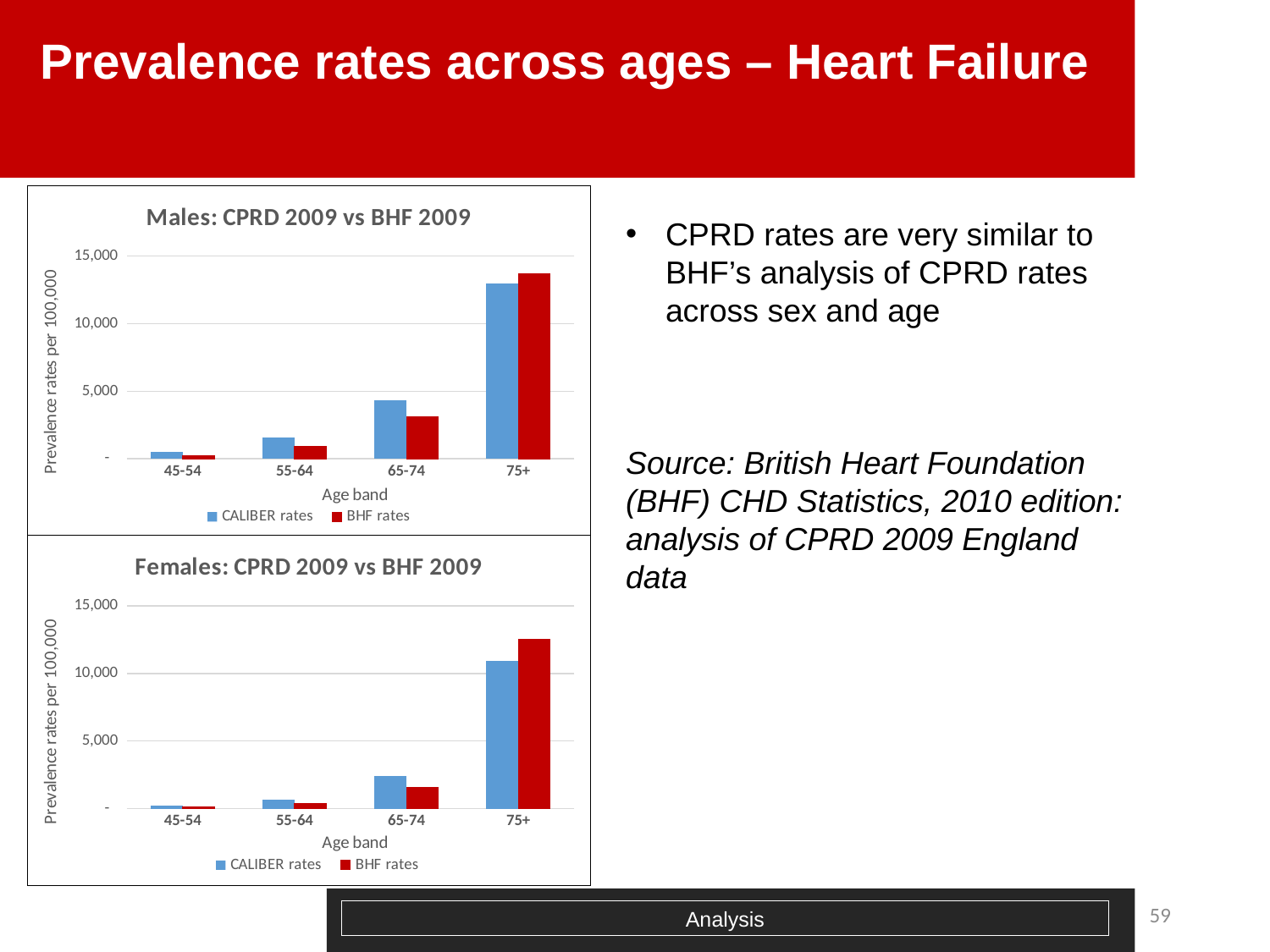
In the 'Females: CPRD 2009 vs BHF 2009' chart, do the CALIBER rates rise or fall as the age band increases? Rise In the 'Females: CPRD 2009 vs BHF 2009' chart, is the BHF rate for the 65-74 age band greater or less than 5,000? less In the 'Females: CPRD 2009 vs BHF 2009' chart, for the 75+ age band, which is larger: the CALIBER rate or the BHF rate? BHF rate In the 'Males: CPRD 2009 vs BHF 2009' chart, for the 65-74 age band, which is larger: the CALIBER rate or the BHF rate? CALIBER rate In the 'Males: CPRD 2009 vs BHF 2009' chart, which age band has the highest CALIBER rate? 75+ In the 'Males: CPRD 2009 vs BHF 2009' chart, how many age bands are shown on the x axis? 4 In the 'Females: CPRD 2009 vs BHF 2009' chart, how many series does the legend list? 2 In the 'Females: CPRD 2009 vs BHF 2009' chart, which colour represents the BHF rates? Red In the 'Males: CPRD 2009 vs BHF 2009' chart, what kind of chart is shown? Bar chart What is the y-axis label of the 'Males: CPRD 2009 vs BHF 2009' chart? Prevalence rates per 100,000 In the 'Females: CPRD 2009 vs BHF 2009' chart, which age band has the lowest BHF rate? 45-54 In the 'Males: CPRD 2009 vs BHF 2009' chart, is the CALIBER rate for the 75+ age band greater or less than 10,000? greater